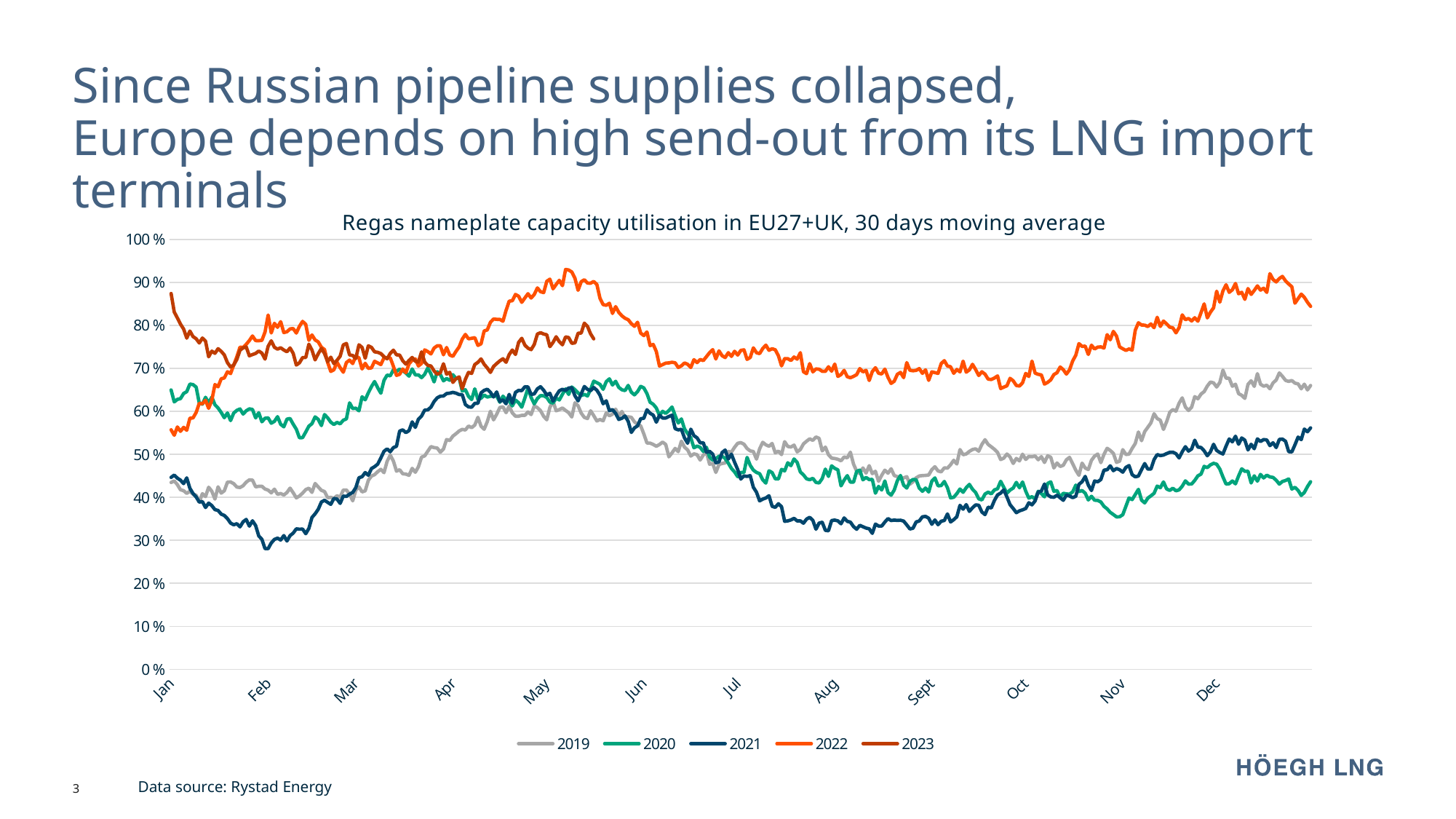
How many series does the legend list? 5 What is the title of the chart? Regas nameplate capacity utilisation in EU27+UK, 30 days moving average In Aug, which series has the larger value, 2022 or 2021? 2022 Does the 2022 line rise or fall between Jun and Aug? Fall Is the value for 2023 in Jan greater or less than 80%? greater Is the value for 2021 in Aug greater or less than 40%? less How many months are labelled along the x axis? 12 Is the value for 2021 in Feb greater or less than 40%? less What kind of chart is shown on the slide? Line chart Which series has the highest value in Dec? 2022 Which series has the lowest value in Feb? 2021